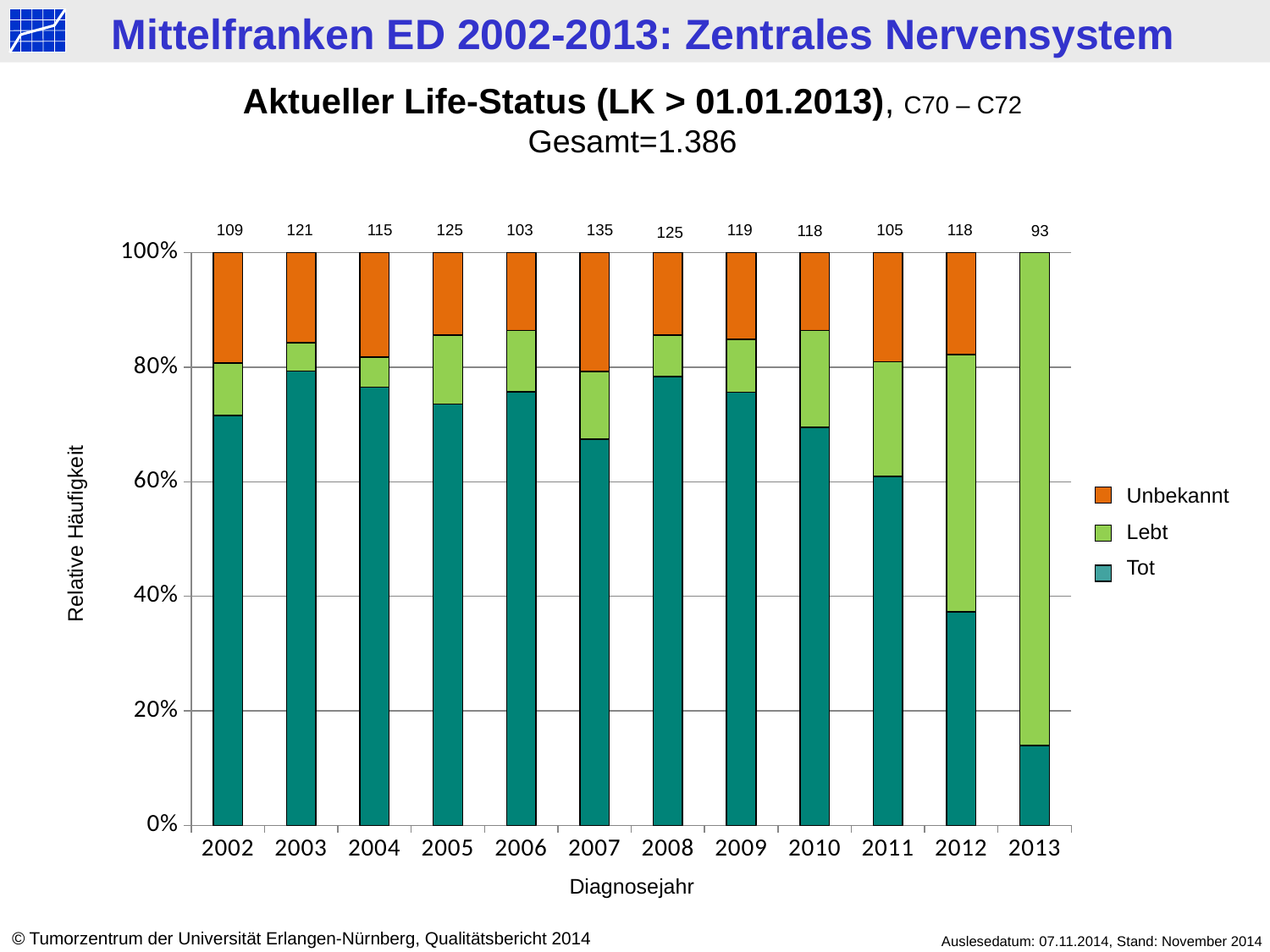
What is the difference between the numbers printed above the bars for 2007 and 2013? 42 Which year has the lowest number printed above its bar? 2013 Is the share of 'Tot' in 2013 greater or less than 20%? less How many series does the legend list? 3 What is the number printed above the bar for 2007? 135 Which year has the highest number printed above its bar? 2007 Which year has the larger number printed above its bar, 2003 or 2006? 2003 What is the number printed above the bar for 2013? 93 What kind of chart is shown on the slide? stacked bar chart How many diagnosis years (categories) are shown on the x axis? 12 What is the number printed above the bar for 2002? 109 What is the title of the x axis? Diagnosejahr